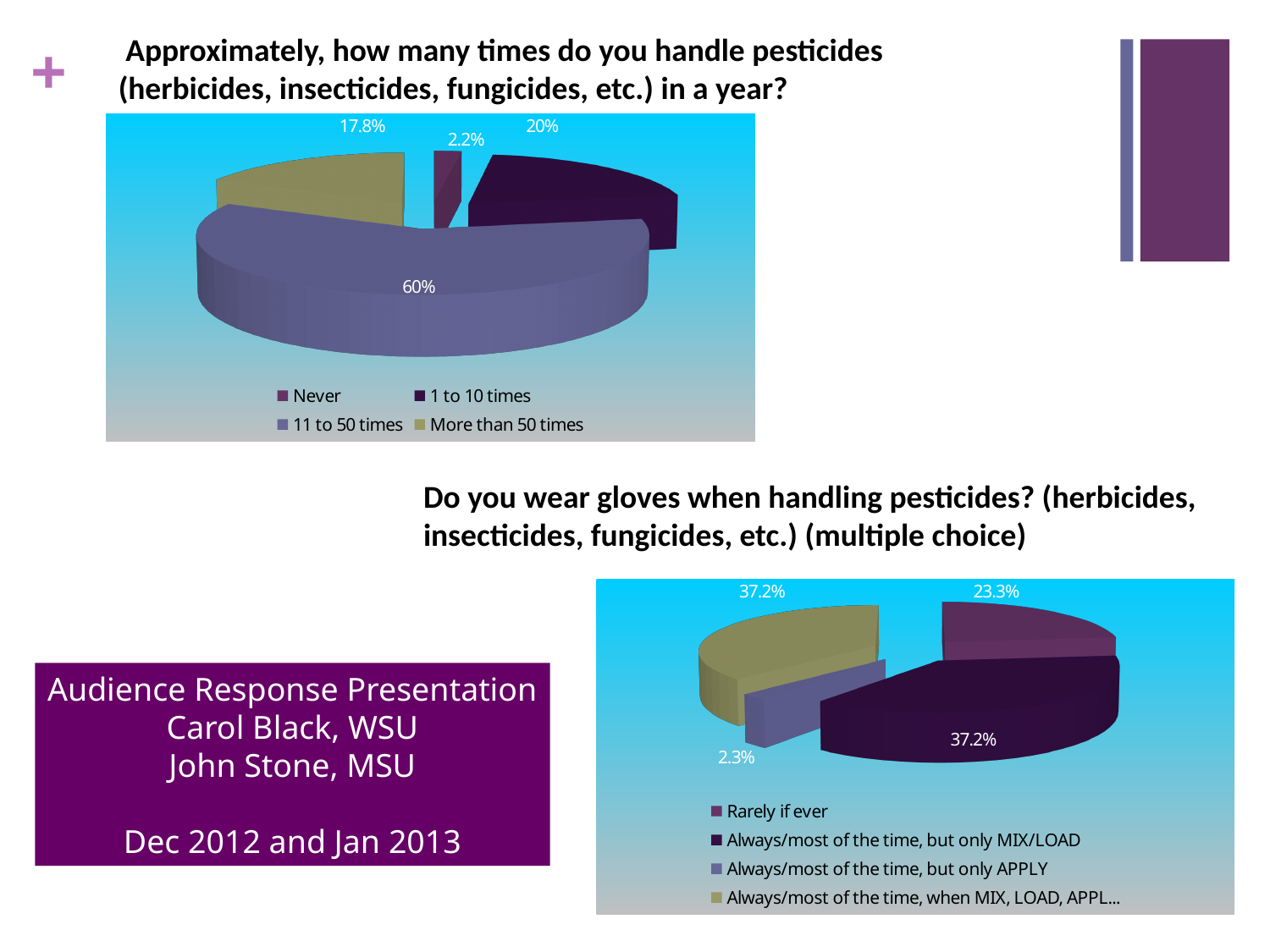
In the top pie chart about how many times pesticides are handled in a year, which category has the largest share? 11 to 50 times In the top pie chart about how many times pesticides are handled in a year, which category has the smallest share? Never In the bottom pie chart about wearing gloves when handling pesticides, which is larger: 'Rarely if ever' or 'Always/most of the time, but only MIX/LOAD'? Always/most of the time, but only MIX/LOAD In the bottom pie chart about wearing gloves when handling pesticides, what percentage is shown for 'Rarely if ever'? 23.3% In the top pie chart about how many times pesticides are handled in a year, what percentage is shown for 'More than 50 times'? 17.8% In the top pie chart about how many times pesticides are handled in a year, what is the difference between the '1 to 10 times' and 'More than 50 times' percentages? 2.2% In the top pie chart about how many times pesticides are handled in a year, how many categories does the legend list? 4 In the top pie chart about how many times pesticides are handled in a year, what percentage is shown for 'Never'? 2.2% In the bottom pie chart about wearing gloves when handling pesticides, which category has the smallest share? Always/most of the time, but only APPLY In the bottom pie chart about wearing gloves when handling pesticides, what percentage is shown for 'Always/most of the time, but only APPLY'? 2.3% In the top pie chart about how many times pesticides are handled in a year, what percentage is shown for '11 to 50 times'? 60% What type of chart is used for the question about wearing gloves when handling pesticides? Pie chart